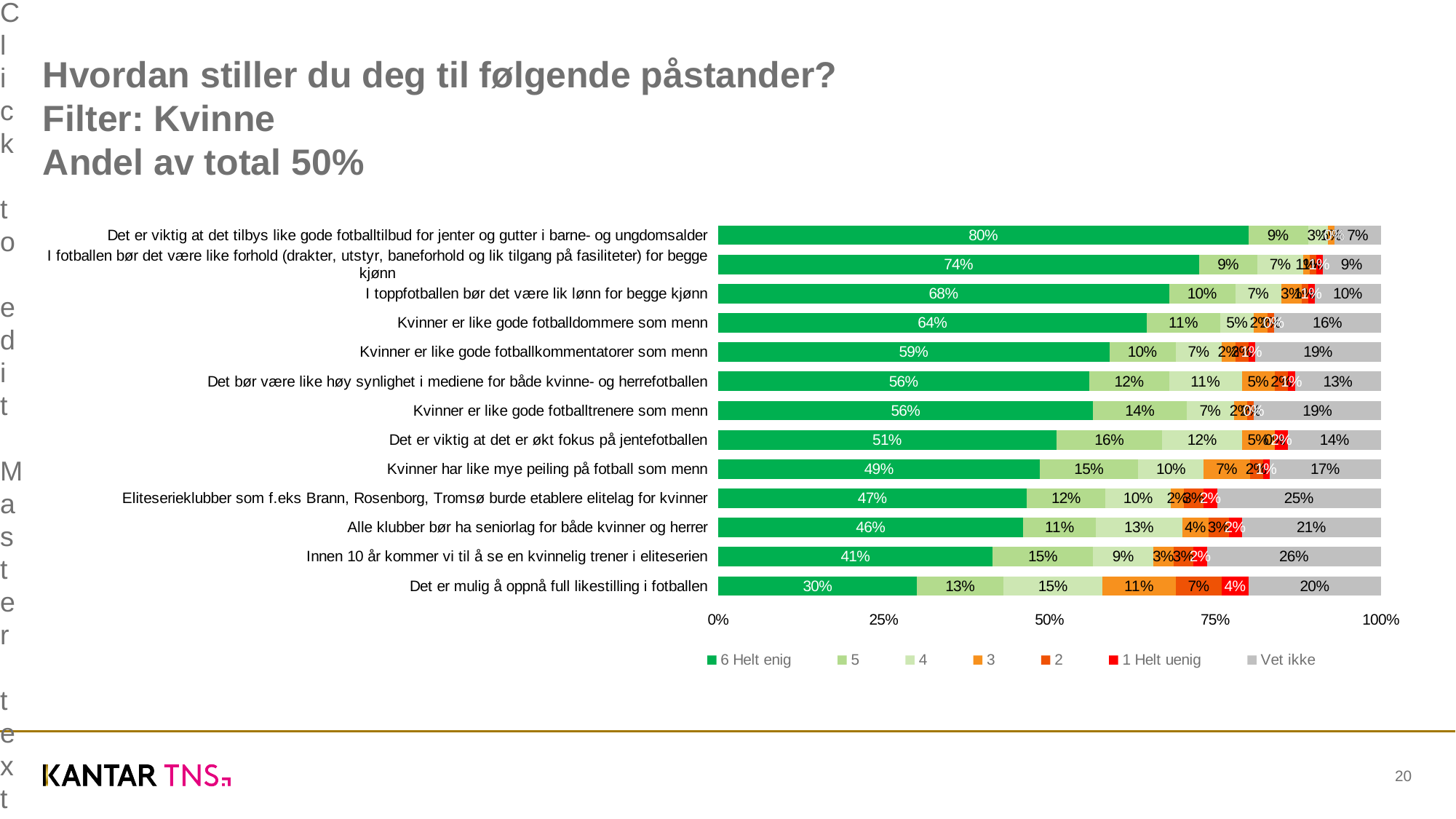
Which statement has the lowest '6 Helt enig' value? Det er mulig å oppnå full likestilling i fotballen What kind of chart is shown on the slide? Stacked bar chart Which statement has the highest '6 Helt enig' value? Det er viktig at det tilbys like gode fotballtilbud for jenter og gutter i barne- og ungdomsalder What is the '6 Helt enig' value for 'Det er viktig at det tilbys like gode fotballtilbud for jenter og gutter i barne- og ungdomsalder'? 80% What is the difference between the '6 Helt enig' values for 'I toppfotballen bør det være lik lønn for begge kjønn' and 'Kvinner er like gode fotballdommere som menn'? 4% Is the '6 Helt enig' value for 'Kvinner har like mye peiling på fotball som menn' greater or less than 50%? less What is the '4' value for 'Alle klubber bør ha seniorlag for både kvinner og herrer'? 13% What is the 'Vet ikke' value for 'Innen 10 år kommer vi til å se en kvinnelig trener i eliteserien'? 26% How many statements (categories) are plotted in the chart? 13 Which has a larger '5' value: 'Det er viktig at det er økt fokus på jentefotballen' or 'Kvinner er like gode fotballtrenere som menn'? Det er viktig at det er økt fokus på jentefotballen How many series does the legend list? 7 What is the '3' value for 'Det er mulig å oppnå full likestilling i fotballen'? 11%